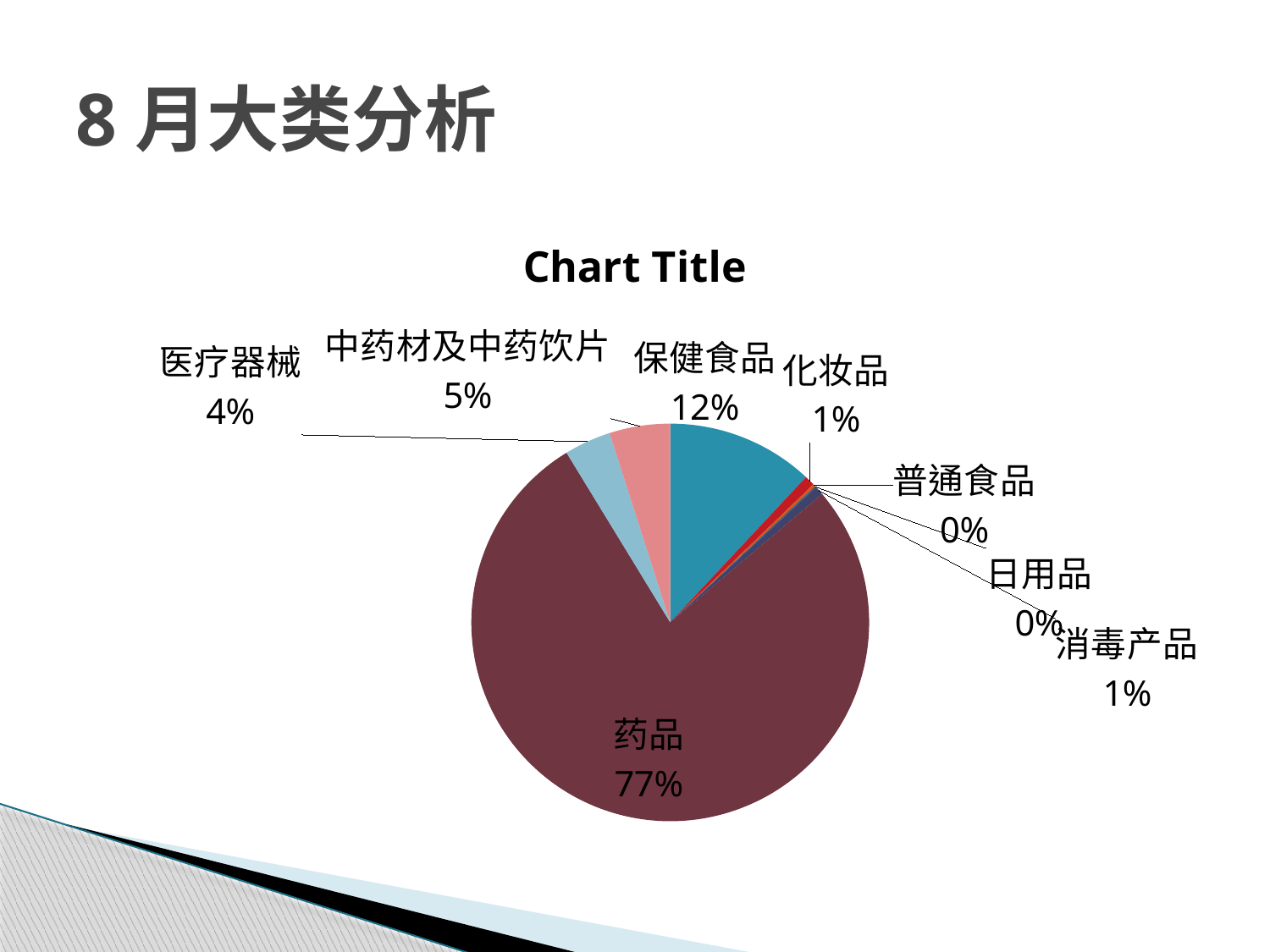
What is the value shown for 中药材及中药饮片? 5% Which category has the largest slice of the pie? 药品 What is the difference in percentage points between 药品 and 保健食品? 65 What is the value shown for 普通食品? 0% Which is larger, the slice for 保健食品 or the slice for 医疗器械? 保健食品 What is the title of the chart? Chart Title How many categories are shown in the pie chart? 8 What share of the pie does 保健食品 account for? 12% What is the value shown for 医疗器械? 4% What share of the pie does 药品 account for? 77% What is the value shown for 化妆品? 1% What kind of chart is shown on the slide? pie chart